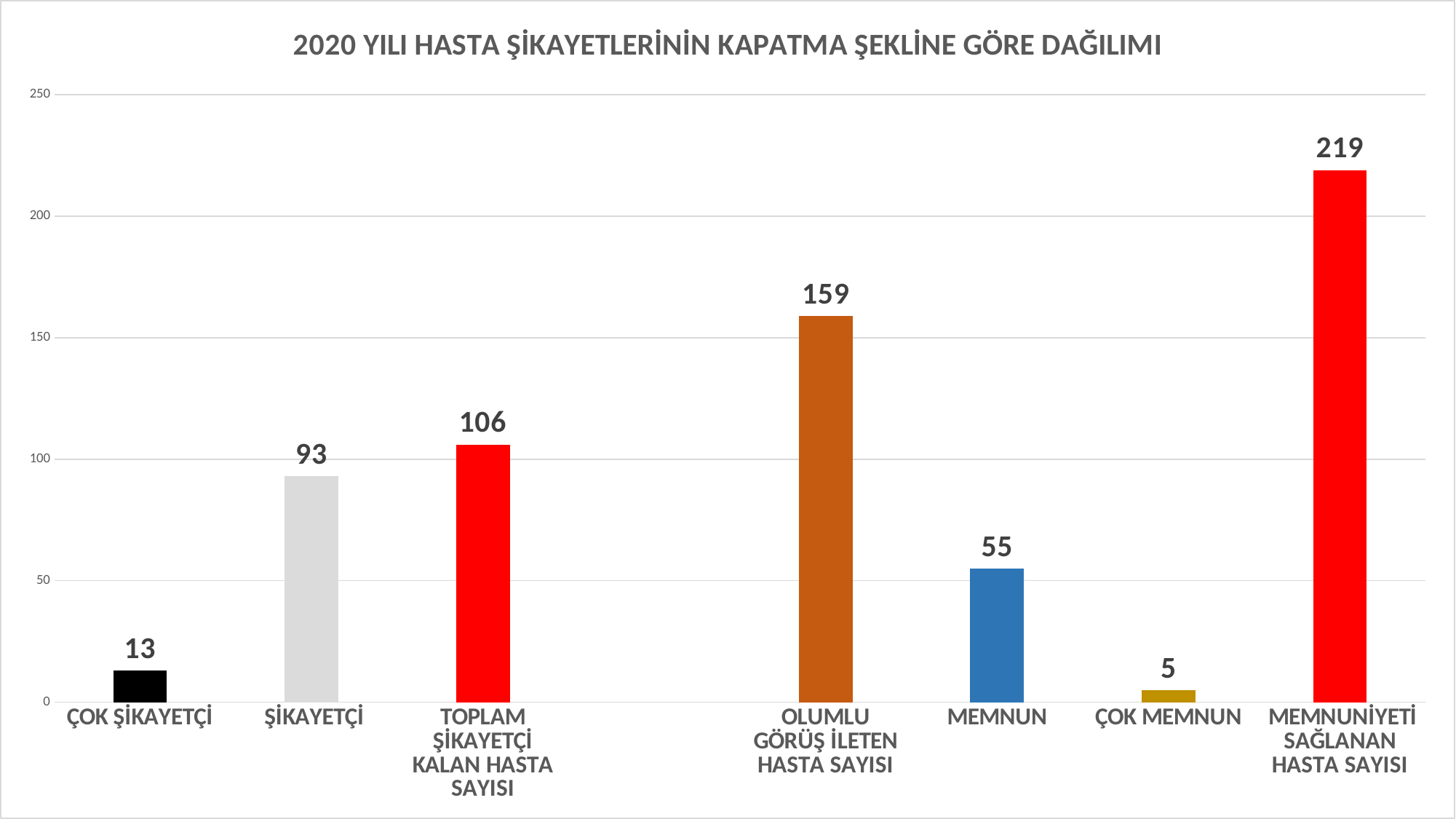
What is the value for MEMNUNİYETİ SAĞLANAN HASTA SAYISI? 219 What is the difference between the values for TOPLAM ŞİKAYETÇİ KALAN HASTA SAYISI and ŞİKAYETÇİ? 13 What is the value for ŞİKAYETÇİ? 93 Which category has the highest value? MEMNUNİYETİ SAĞLANAN HASTA SAYISI What is the difference between the values for MEMNUNİYETİ SAĞLANAN HASTA SAYISI and OLUMLU GÖRÜŞ İLETEN HASTA SAYISI? 60 What is the value for ÇOK ŞİKAYETÇİ? 13 Which is larger, the value for MEMNUN or the value for ŞİKAYETÇİ? ŞİKAYETÇİ How many categories are shown on the chart? 7 What kind of chart is shown on the slide? Bar chart What is the title of the chart? 2020 YILI HASTA ŞİKAYETLERİNİN KAPATMA ŞEKLİNE GÖRE DAĞILIMI What is the value for OLUMLU GÖRÜŞ İLETEN HASTA SAYISI? 159 Which category has the lowest value? ÇOK MEMNUN